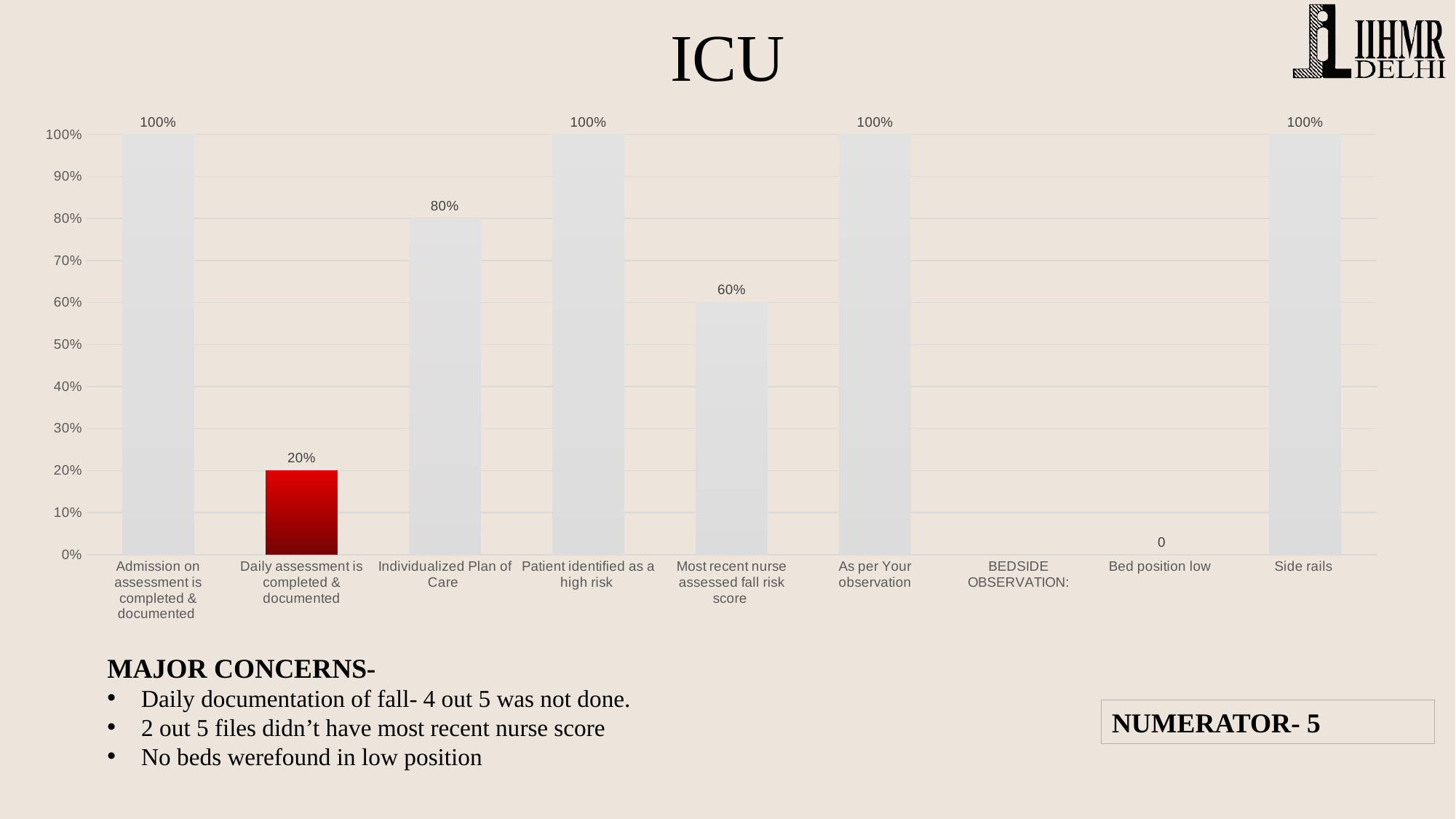
What is the title of the chart? ICU What kind of chart is shown on the slide? Bar chart What is the value for Most recent nurse assessed fall risk score? 60% Which category has the lowest value? Bed position low What is the value for Individualized Plan of Care? 80% What is the value for Side rails? 100% What is the value for Daily assessment is completed & documented? 20% What is the value for Bed position low? 0 Which category's bar is coloured red? Daily assessment is completed & documented Which is larger, Daily assessment is completed & documented or Most recent nurse assessed fall risk score? Most recent nurse assessed fall risk score What is the difference between Individualized Plan of Care and Most recent nurse assessed fall risk score? 20% How many bars are labelled 100%? 4